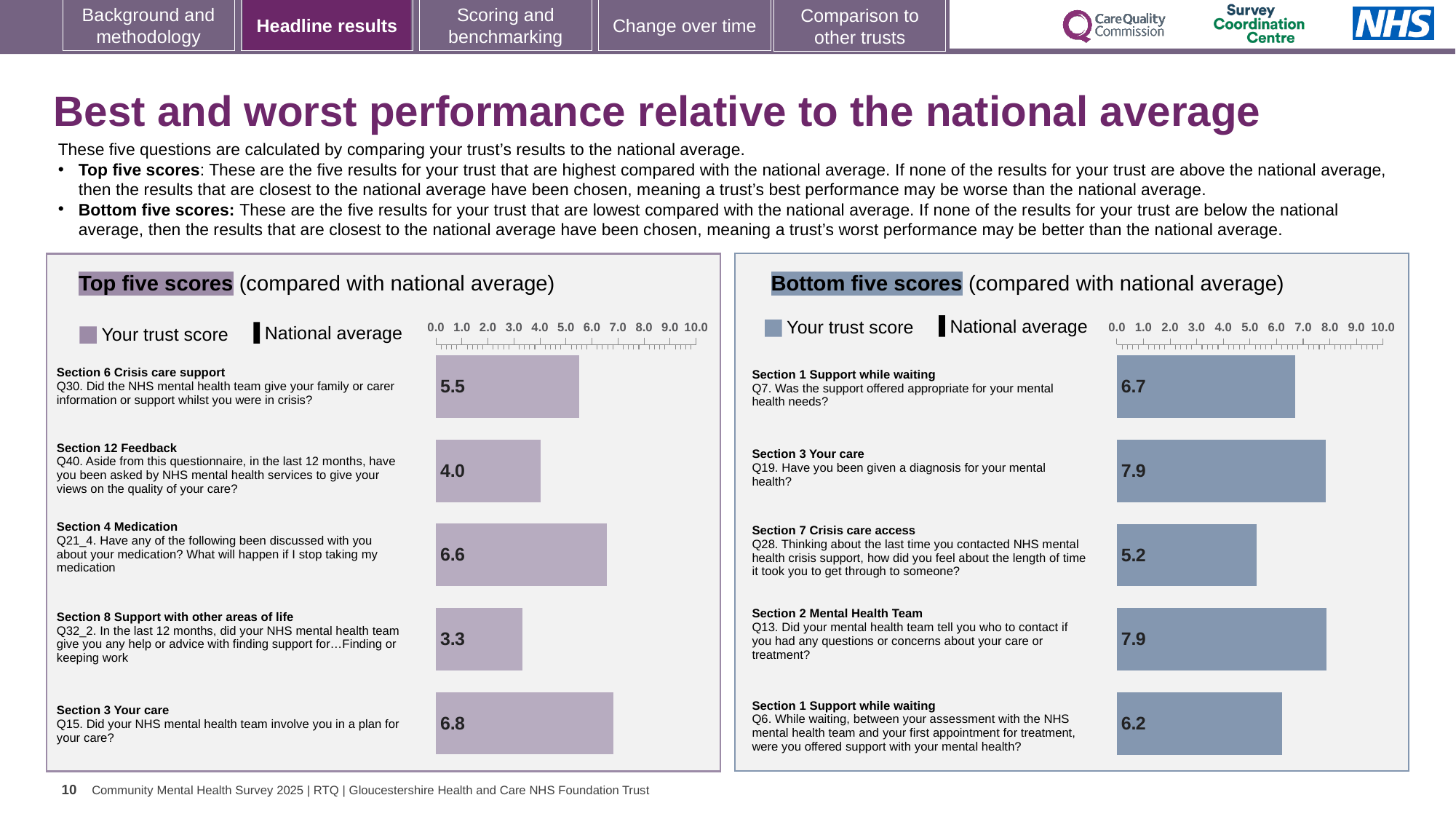
In the 'Bottom five scores' chart, what is the difference between the trust scores for Q19 and Q7? 1.2 In the 'Top five scores' chart, which question has the lowest trust score? Q32_2 (Section 8 Support with other areas of life) In the 'Top five scores' chart, which question has the highest trust score? Q15 (Section 3 Your care) In the 'Top five scores' chart, what is the trust score for Q30 (Section 6 Crisis care support)? 5.5 In the 'Top five scores' chart, what is the difference between the trust scores for Q15 and Q32_2? 3.5 In the 'Bottom five scores' chart, what is the trust score for Q28 (Section 7 Crisis care access)? 5.2 In the 'Top five scores' chart, what is the trust score for Q40 (Section 12 Feedback)? 4.0 What kind of chart is the 'Bottom five scores' chart? Bar chart How many questions are shown in the 'Top five scores' chart? 5 In the 'Bottom five scores' chart, which has the larger trust score: Q7 or Q6? Q7 In the 'Bottom five scores' chart, which question has the lowest trust score? Q28 (Section 7 Crisis care access) In the 'Bottom five scores' chart, what is the trust score for Q6 (Section 1 Support while waiting)? 6.2